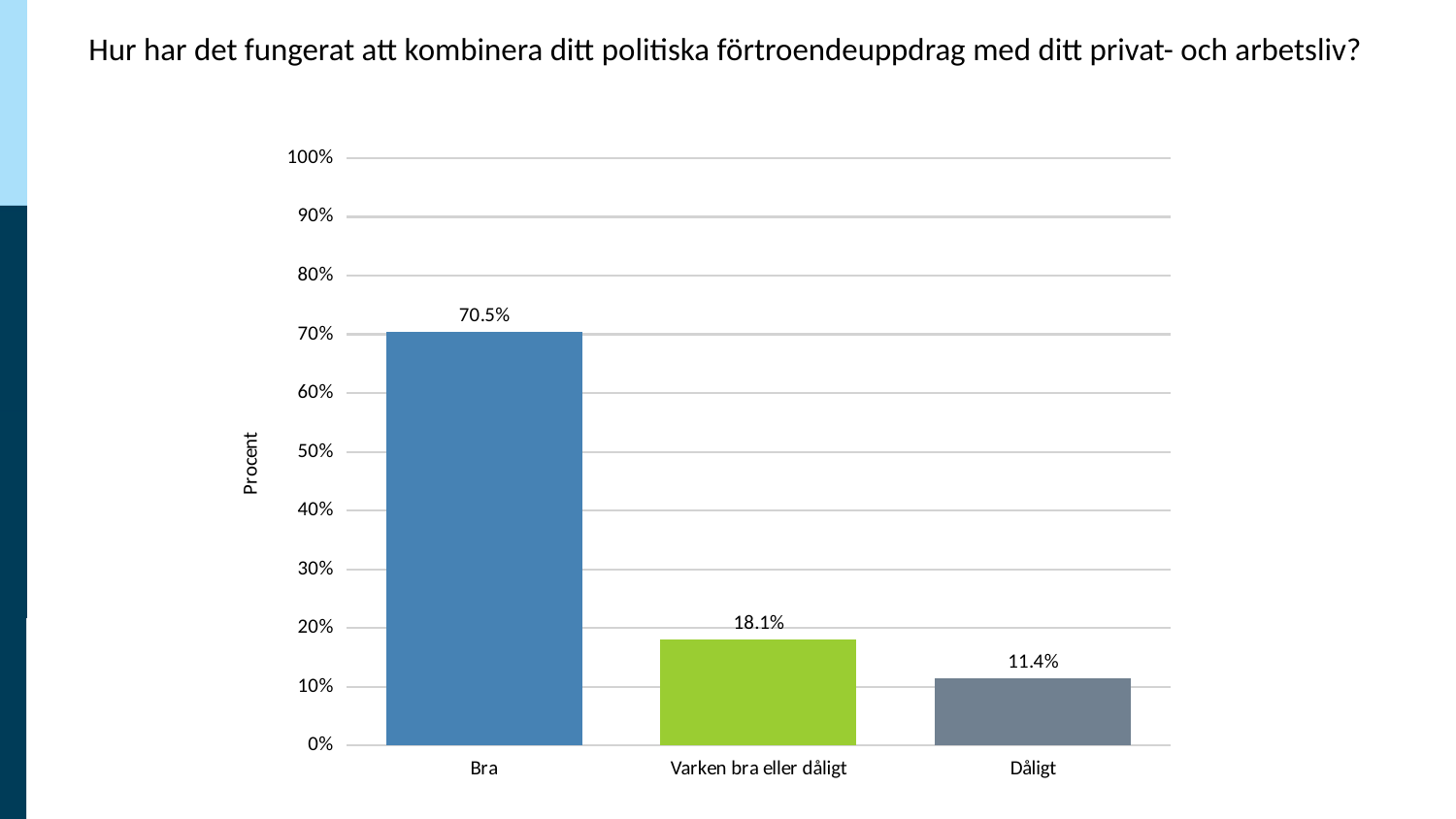
Which category has the highest value? Bra What is the difference between the values for "Varken bra eller dåligt" and "Dåligt"? 6.7% What is the value for "Dåligt"? 11.4% What kind of chart is shown on the slide? bar chart What is the label of the y axis? Procent What is the difference between the values for "Bra" and "Dåligt"? 59.1% How many categories are shown on the x axis? 3 What is the value for "Bra"? 70.5% Is the value for "Bra" greater or less than 60%? greater Which is larger, the value for "Varken bra eller dåligt" or the value for "Dåligt"? Varken bra eller dåligt What is the value for "Varken bra eller dåligt"? 18.1% Which category has the lowest value? Dåligt